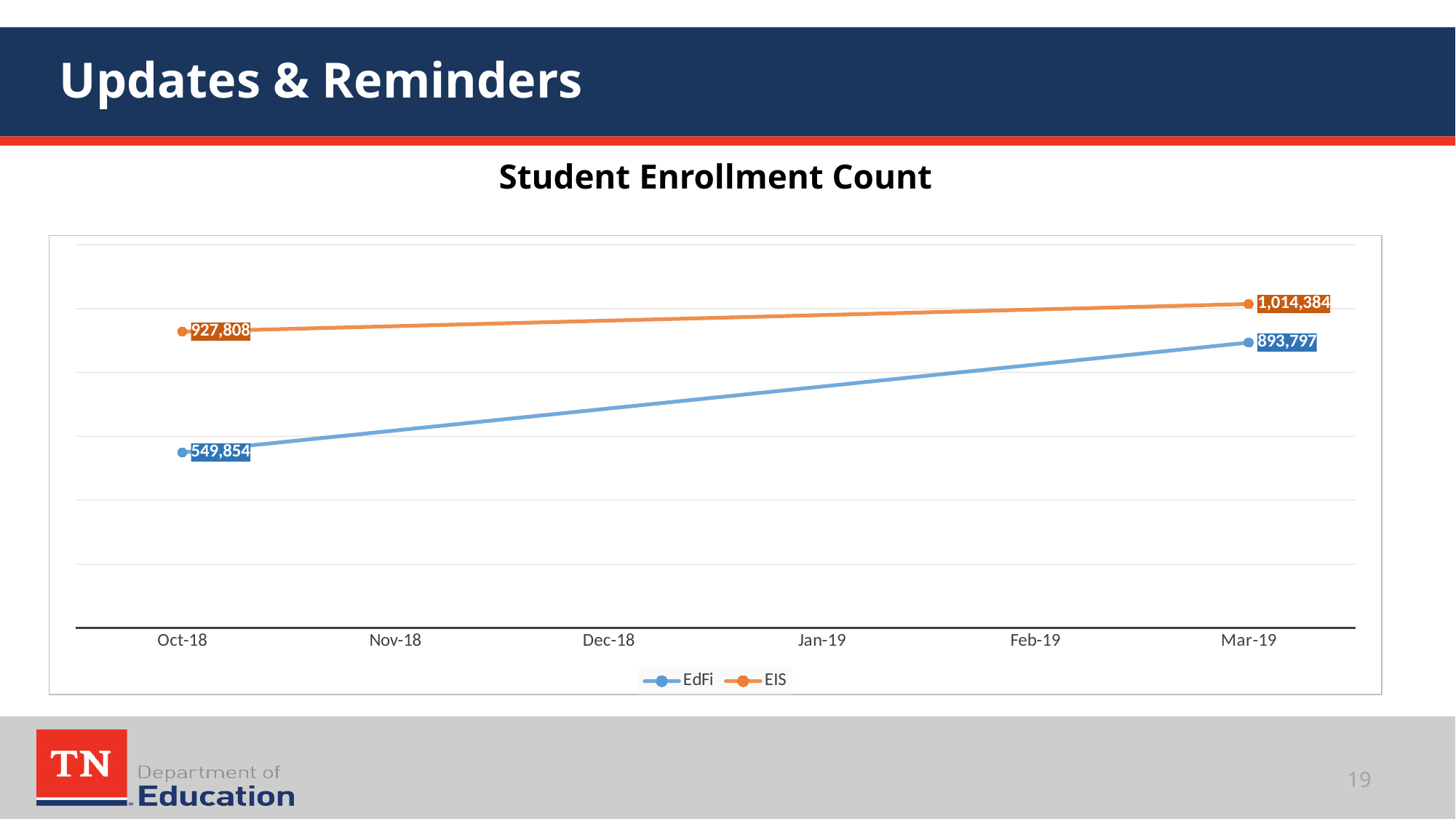
By how much did the EdFi enrollment count increase from Oct-18 to Mar-19? 343,943 What kind of chart is shown on the slide? line chart What is the EdFi student enrollment count for Mar-19? 893,797 Which series has the higher enrollment count in Mar-19, EdFi or EIS? EIS How many series does the legend list? 2 What is the difference between the EIS and EdFi enrollment counts in Oct-18? 377,954 What is the EIS student enrollment count for Oct-18? 927,808 By how much did the EIS enrollment count increase from Oct-18 to Mar-19? 86,576 What is the title of the chart? Student Enrollment Count Does the EdFi enrollment count rise or fall from Oct-18 to Mar-19? rise What is the EdFi student enrollment count for Oct-18? 549,854 What is the EIS student enrollment count for Mar-19? 1,014,384